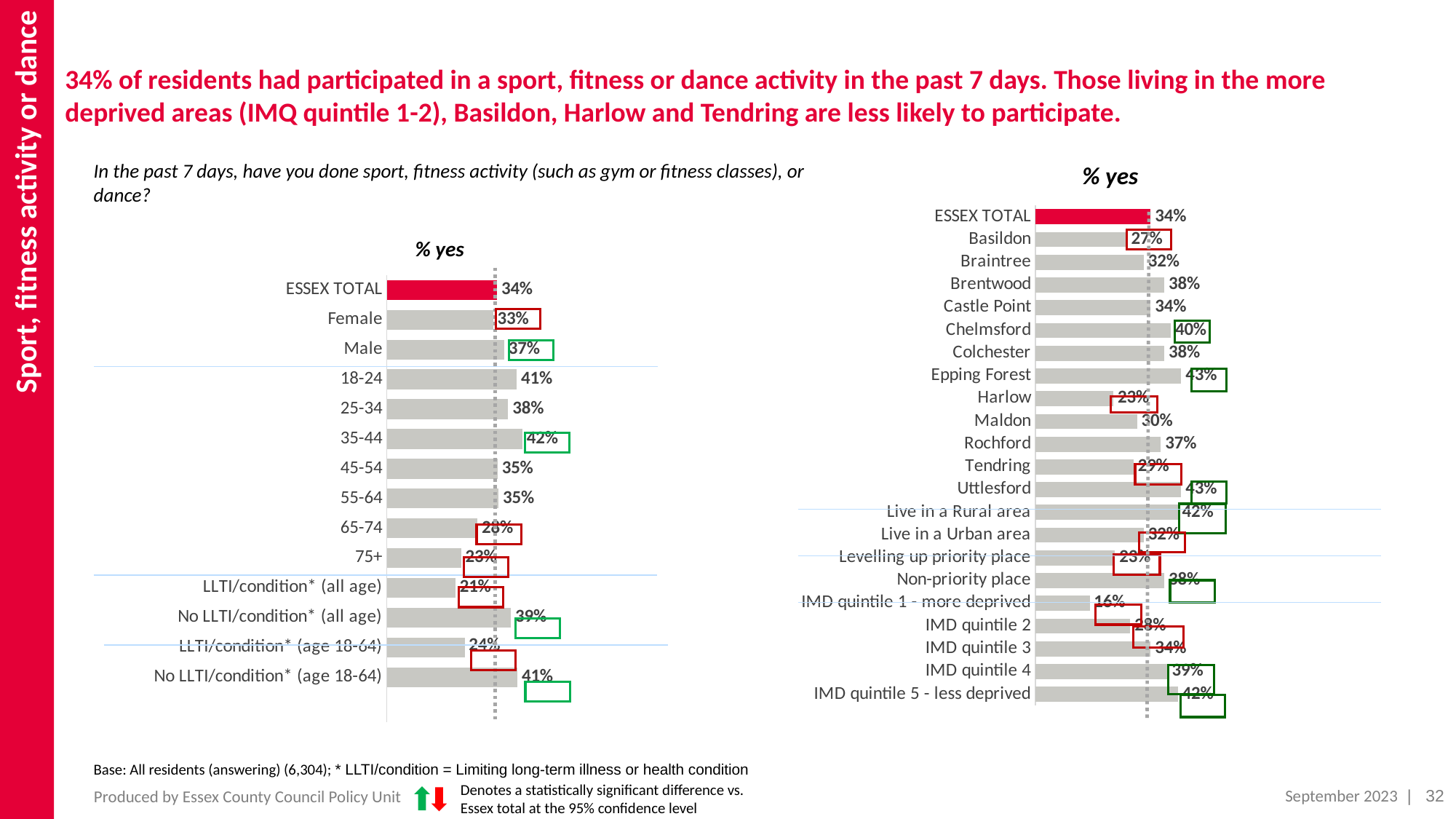
On the left chart, which has a higher % yes, Female or Male? Male On the right chart, what is the % yes value for ESSEX TOTAL, shown in red? 34% On the right chart, which has a higher % yes, Rochford or Braintree? Rochford On the left chart, what is the % yes value for Male? 37% On the right chart, what is the difference in % yes between Brentwood and Basildon? 11 percentage points On the right chart, which category has the lowest % yes? IMD quintile 1 - more deprived What type of chart is used on the right side of the slide? Bar chart On the left chart, what is the % yes value for the 18-24 age group? 41% On the left chart, which age group has the highest % yes? 35-44 On the right chart, what is the % yes value for Chelmsford? 40% On the left chart, how many categories are plotted? 14 On the right chart, what is the % yes value for Maldon? 30%